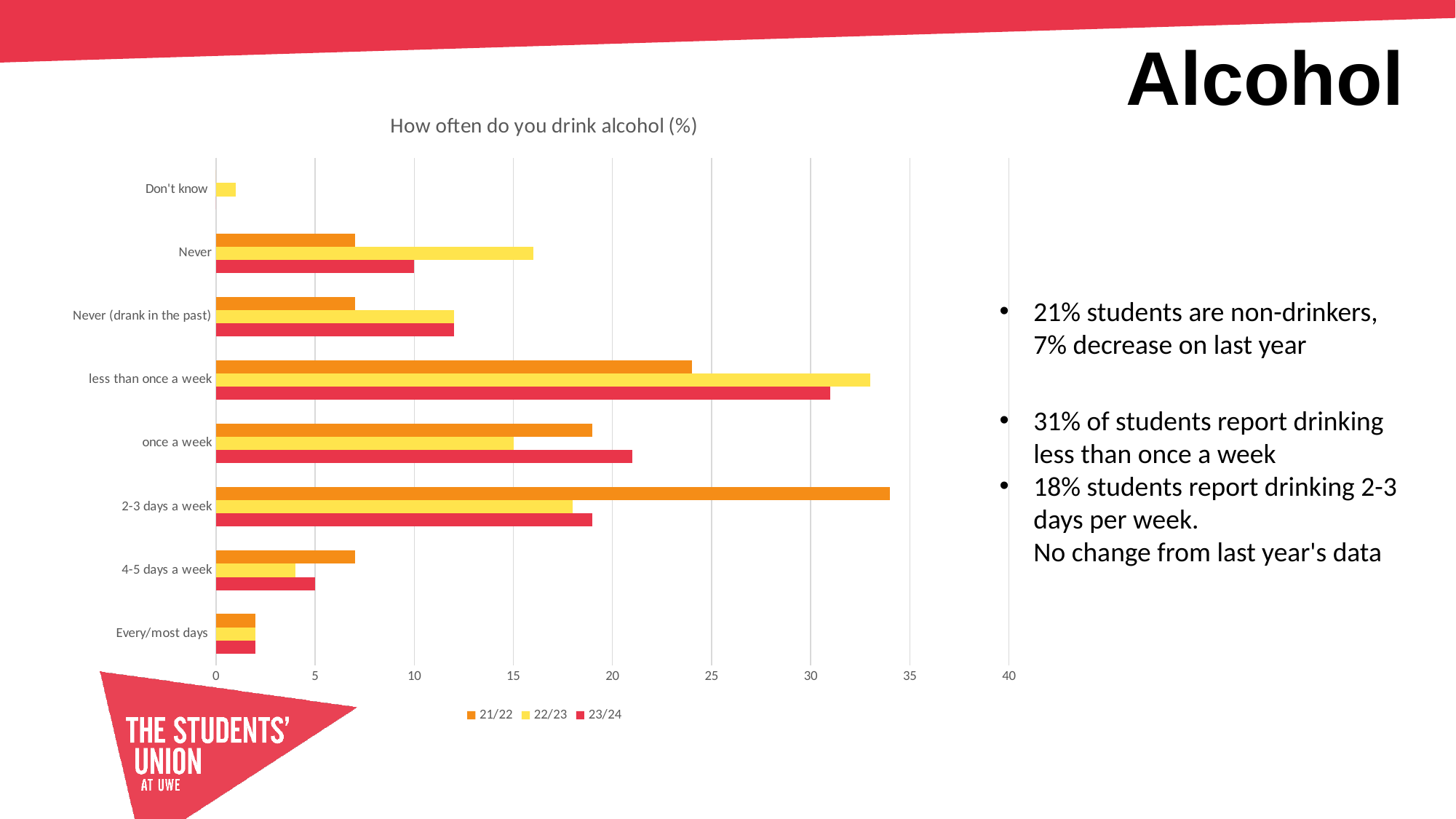
For the 'once a week' category, which series has the larger value, 22/23 or 23/24? 23/24 What kind of chart is shown on the slide? bar chart Is the 21/22 value for '2-3 days a week' greater or less than 30? greater Is the 22/23 value for 'Don't know' greater or less than 5? less Which category has the highest value for the 21/22 series? 2-3 days a week Which series are listed in the chart legend? 21/22, 22/23, 23/24 For the 'Never' category, which series has the larger value, 21/22 or 22/23? 22/23 What is the title of the chart? How often do you drink alcohol (%) How many categories are shown on the chart's vertical axis? 8 Is the 23/24 value for 'Every/most days' greater or less than 5? less Which category has the highest value for the 23/24 series? less than once a week How many series does the chart legend list? 3